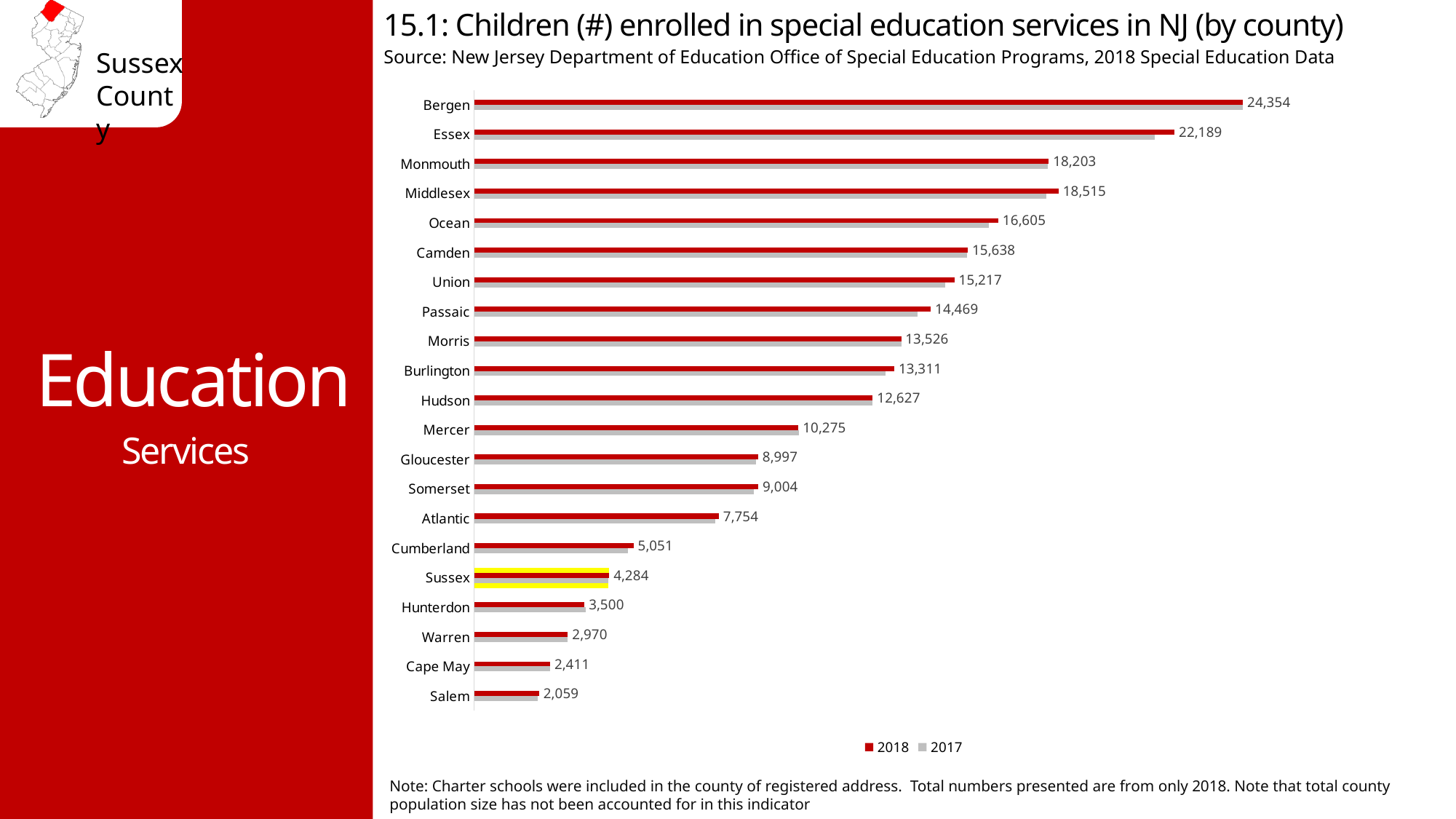
What kind of chart is shown? Bar chart How many counties are shown on the chart? 21 What is the 2018 value for Sussex? 4,284 Which has the larger 2018 value, Middlesex or Monmouth? Middlesex Which county's bars are highlighted in yellow? Sussex Which county has the highest 2018 value? Bergen How many series does the legend list? 2 Which county has the lowest 2018 value? Salem What is the 2018 value for Cumberland? 5,051 What is the difference between the 2018 values for Sussex and Hunterdon? 784 What is the 2018 value for Bergen? 24,354 What is the difference between the 2018 values for Bergen and Essex? 2,165